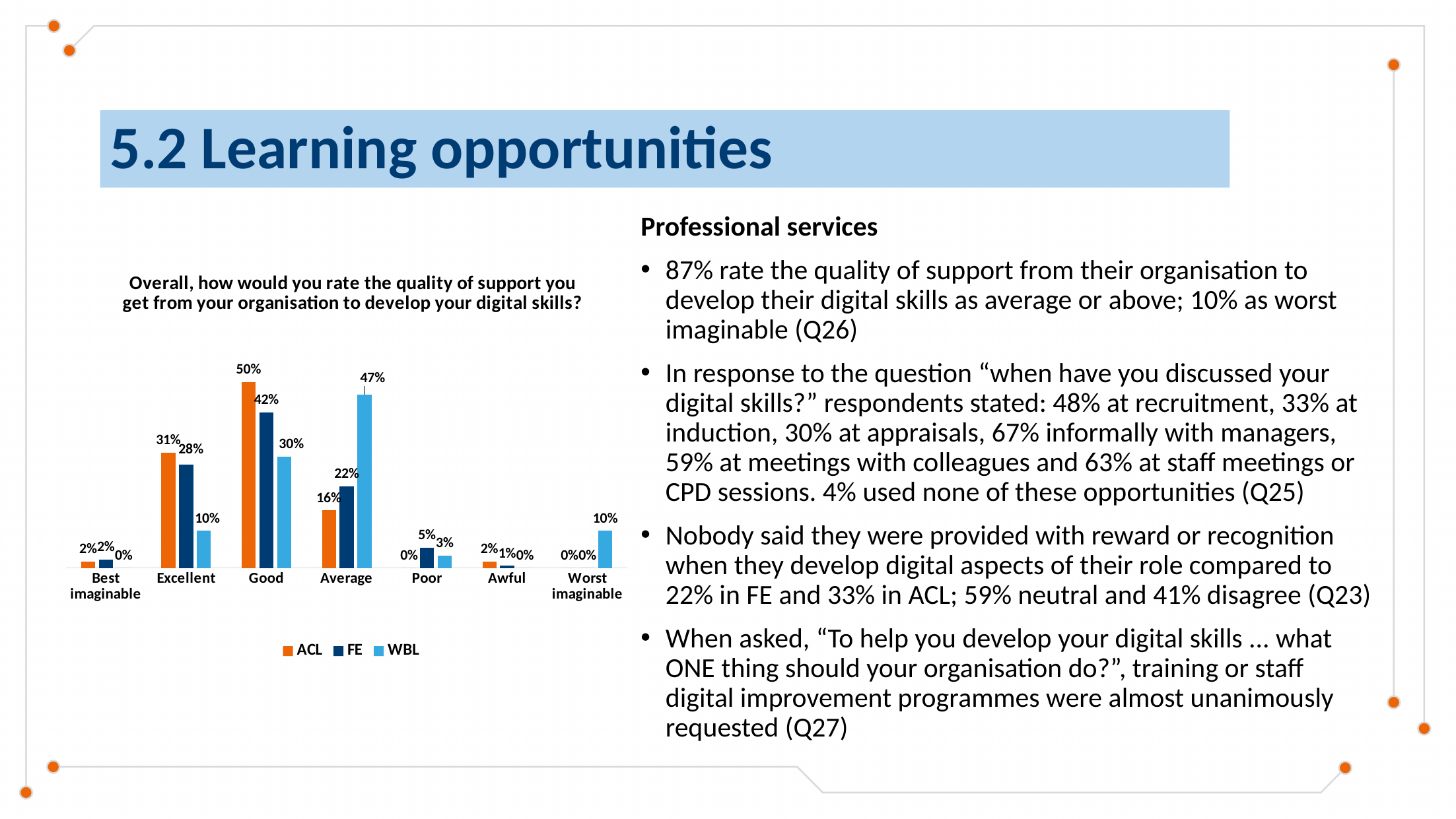
What is the WBL value for Worst imaginable? 10% What is the difference between the WBL and ACL values for Average? 31% For the Excellent category, which series has the larger value, ACL or WBL? ACL What kind of chart is shown on the slide? Bar chart Which category has the highest WBL value? Average Which category has the highest ACL value? Good How many series does the legend list? 3 What is the WBL value for the Average category? 47% What is the difference between the ACL and FE values for Good? 8% What percentage of FE respondents rated the support as Excellent? 28% How many rating categories are shown on the x axis? 7 What percentage of ACL respondents rated the quality of support as Good? 50%